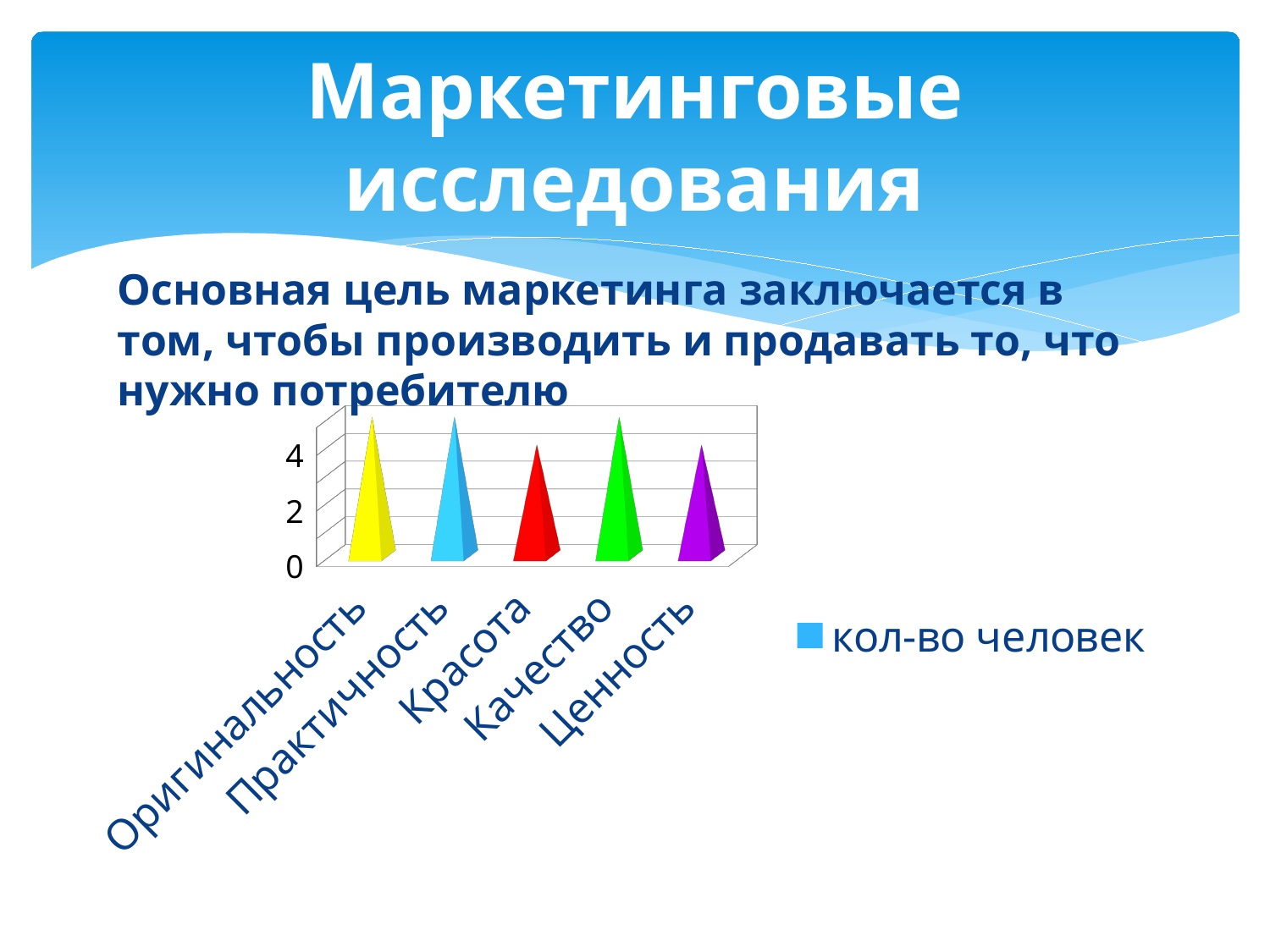
How many categories are shown on the chart's x axis? 5 Is the value for Красота greater or less than 2? greater Is the value for Качество greater or less than 2? greater Is the value for Оригинальность greater or less than 4? greater What kind of chart is shown on the slide? bar chart What is the first category on the x axis of the chart? Оригинальность What is the series name shown in the chart legend? кол-во человек Which is larger, the value for Оригинальность or the value for Красота? Оригинальность Which is larger, the value for Практичность or the value for Ценность? Практичность How many series does the chart legend list? 1 What colour is the bar for Красота? red